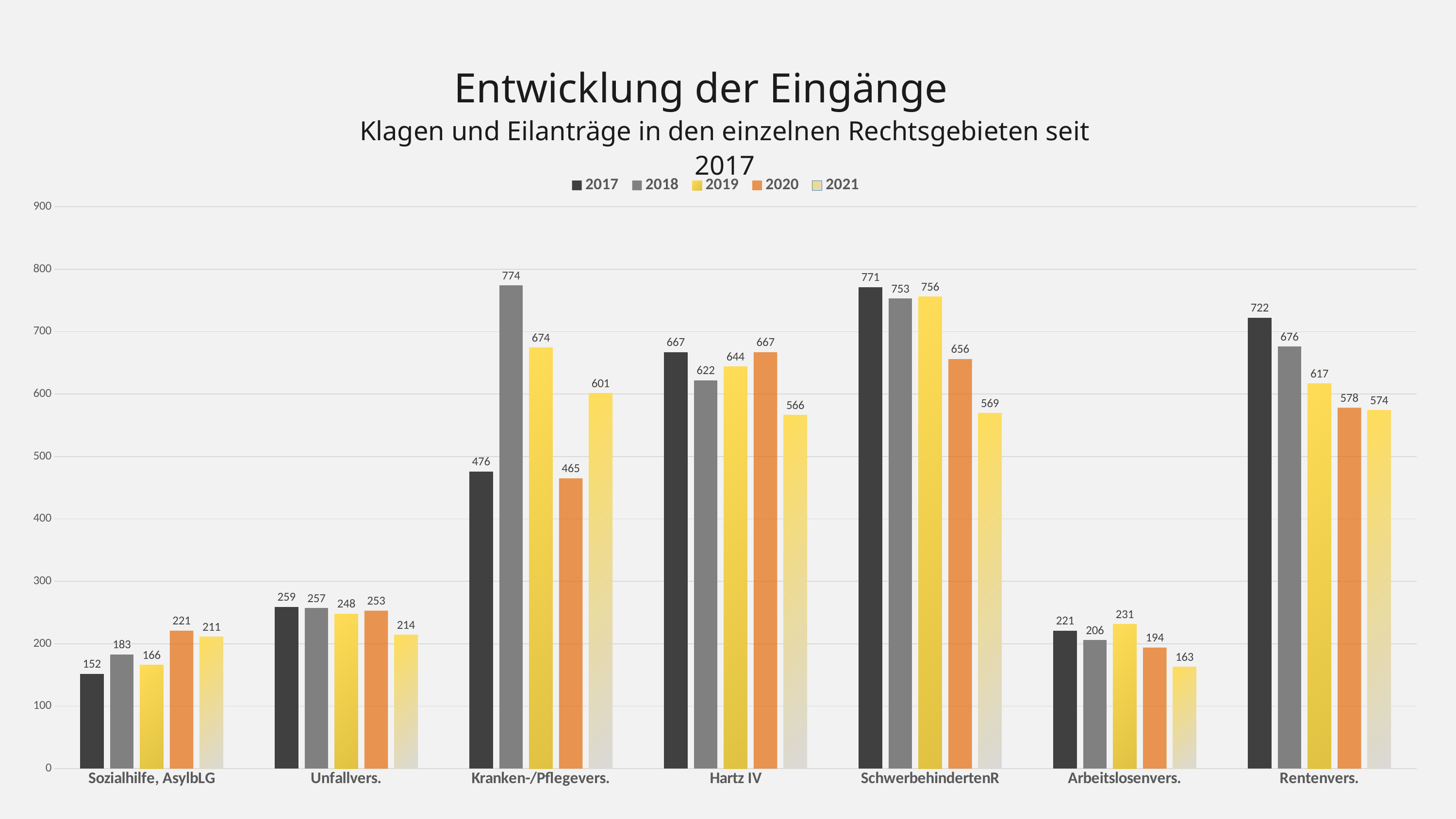
What is the value for Kranken-/Pflegevers. in 2018? 774 Do the values for Rentenvers. rise or fall from 2017 to 2021? Fall Which category has the highest value in 2017? SchwerbehindertenR Which is larger: the 2020 value for Hartz IV or the 2020 value for SchwerbehindertenR? Hartz IV What kind of chart is shown on the slide? Bar chart What is the difference between the 2017 and 2021 values for Rentenvers.? 148 What is the value for Sozialhilfe, AsylbLG in 2017? 152 What is the value for Rentenvers. in 2021? 574 How many categories are shown on the x axis? 7 How many series does the legend list? 5 What is the title of the chart? Entwicklung der Eingänge Which category has the lowest value in 2021? Arbeitslosenvers.